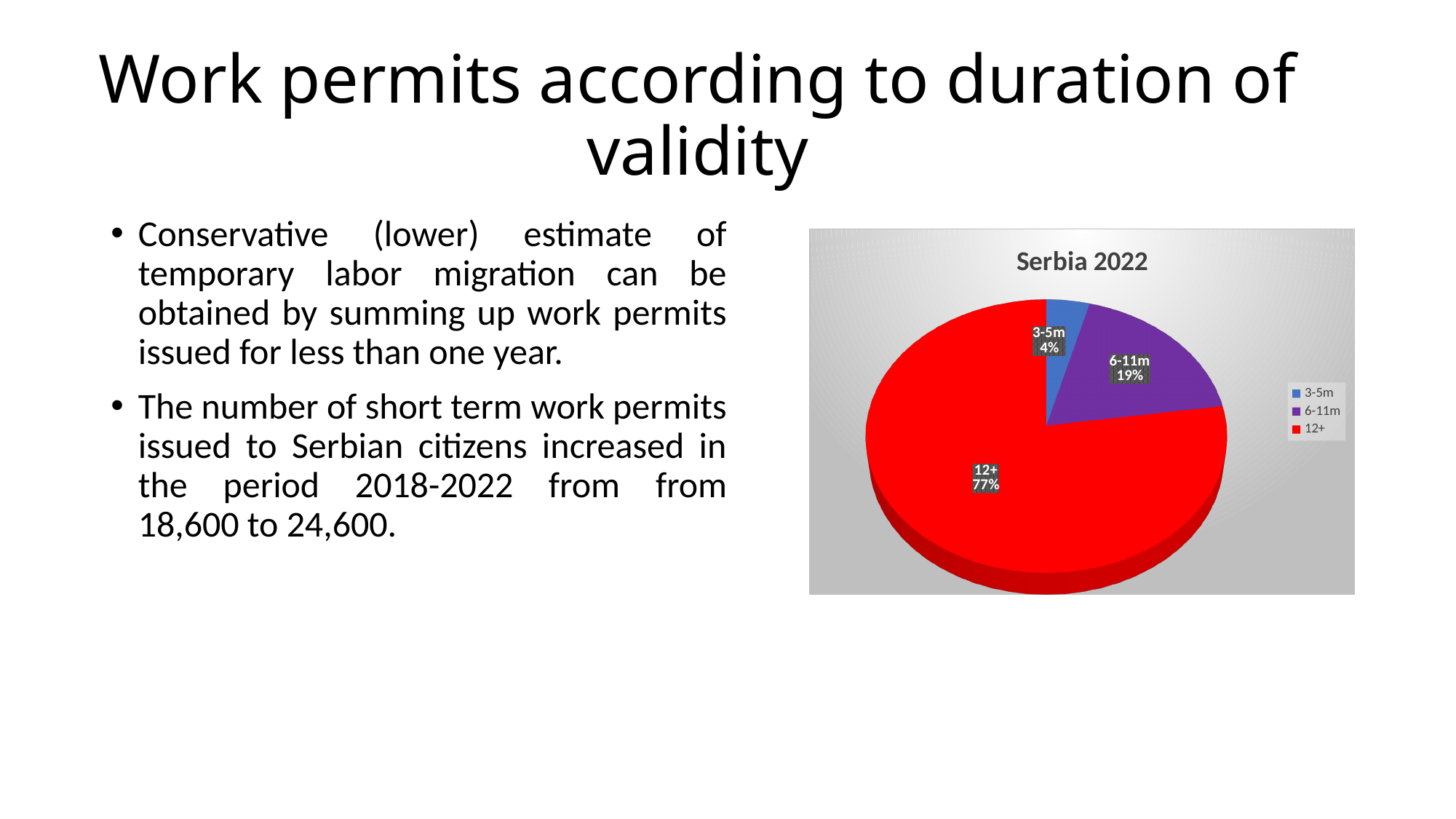
What colour is the 12+ slice? red What is the title of the chart? Serbia 2022 How many slices does the pie chart have? 3 What share of the pie does the 6-11m slice represent? 19% What share of the pie does the 3-5m slice represent? 4% How many entries does the legend list? 3 Which category has the smallest slice of the pie? 3-5m What is the difference in percentage points between the 12+ slice and the 6-11m slice? 58 Which slice is larger, 6-11m or 3-5m? 6-11m What share of the pie does the 12+ slice represent? 77% What kind of chart is shown on the slide? pie chart Which category has the largest slice of the pie? 12+